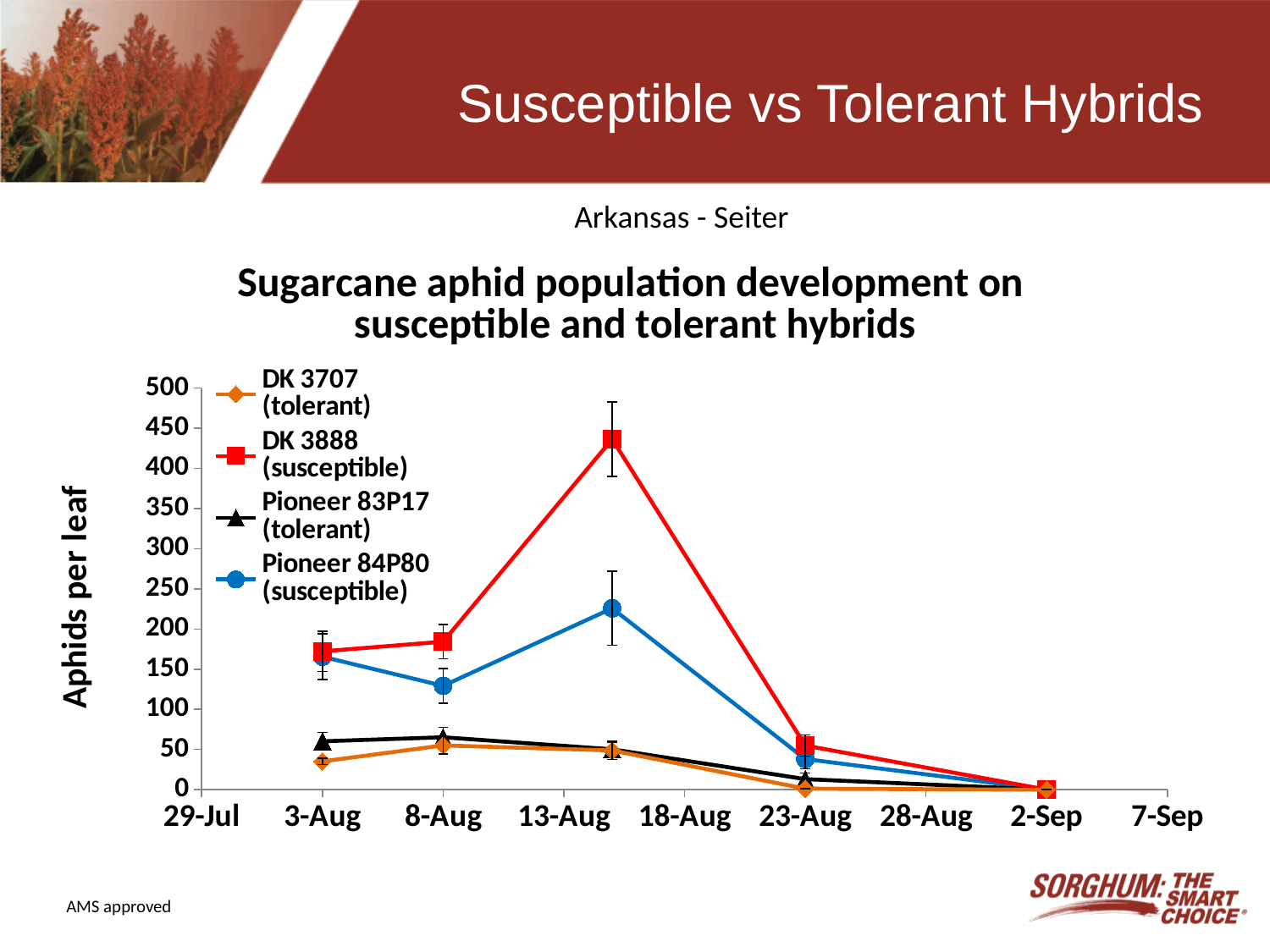
What kind of chart is shown on the slide? line chart What is the label on the vertical axis? Aphids per leaf On 8-Aug, which has the larger value: DK 3888 (susceptible) or Pioneer 84P80 (susceptible)? DK 3888 (susceptible) How many series does the legend list? 4 Which series reaches the highest value on the chart? DK 3888 (susceptible) Is the peak value for DK 3888 (susceptible) greater or less than 400? greater Is the value for Pioneer 84P80 (susceptible) on 8-Aug greater or less than 150? less What is the title of the chart? Sugarcane aphid population development on susceptible and tolerant hybrids Is the value for DK 3707 (tolerant) on 3-Aug greater or less than 50? less Do the values for DK 3888 (susceptible) rise or fall from its mid-August peak to 2-Sep? fall How many data points are plotted for each series? 5